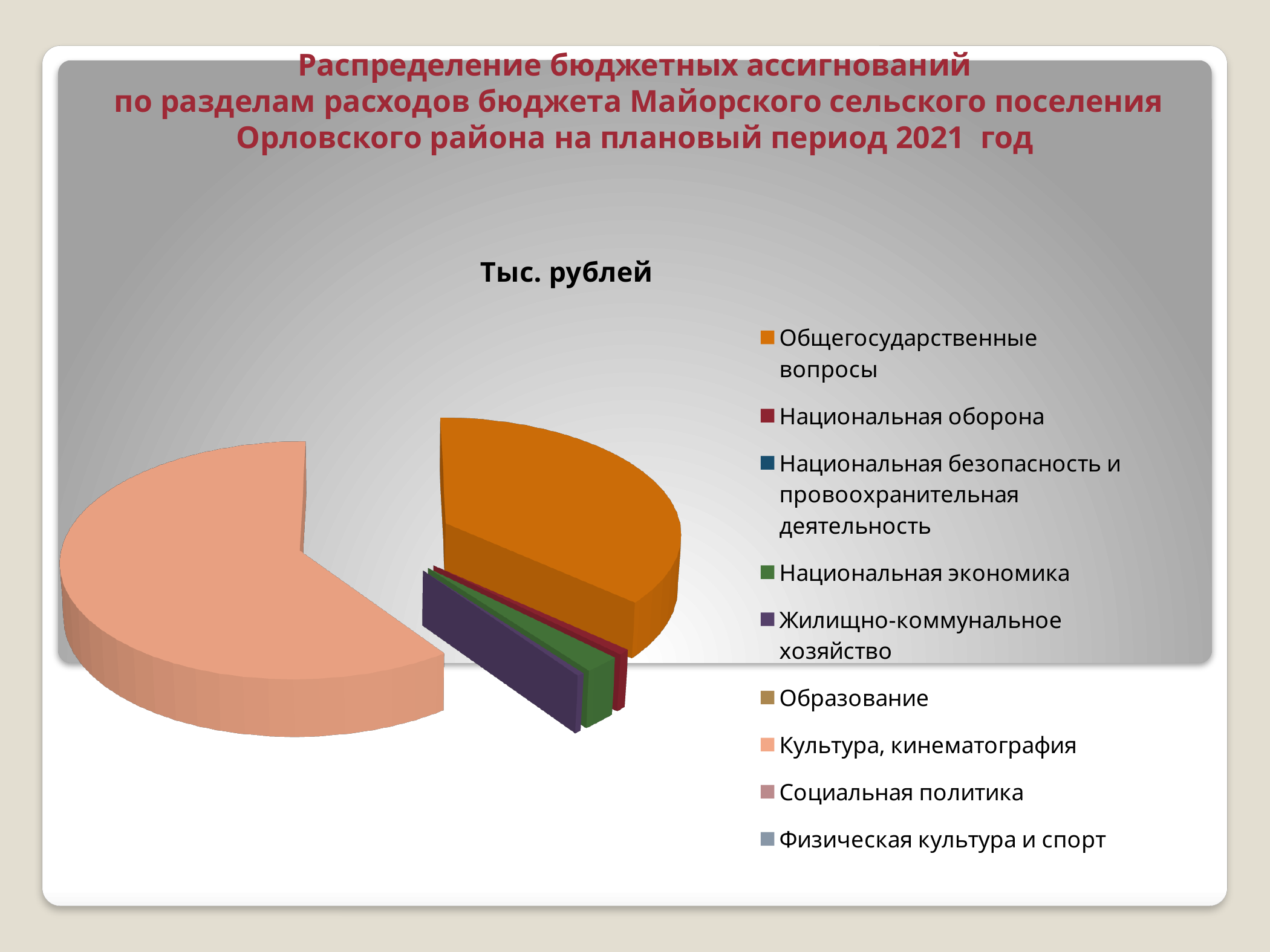
Which slice is larger: Общегосударственные вопросы or Национальная оборона? Общегосударственные вопросы How many categories does the legend of the pie chart list? 9 What kind of chart is shown on the slide? pie chart What colour represents Общегосударственные вопросы in the pie chart? orange What is the title shown above the pie chart? Тыс. рублей Which category has the largest slice in the pie chart? Культура, кинематография Which slice is larger: Общегосударственные вопросы or Жилищно-коммунальное хозяйство? Общегосударственные вопросы Which slice is larger: Культура, кинематография or Общегосударственные вопросы? Культура, кинематография